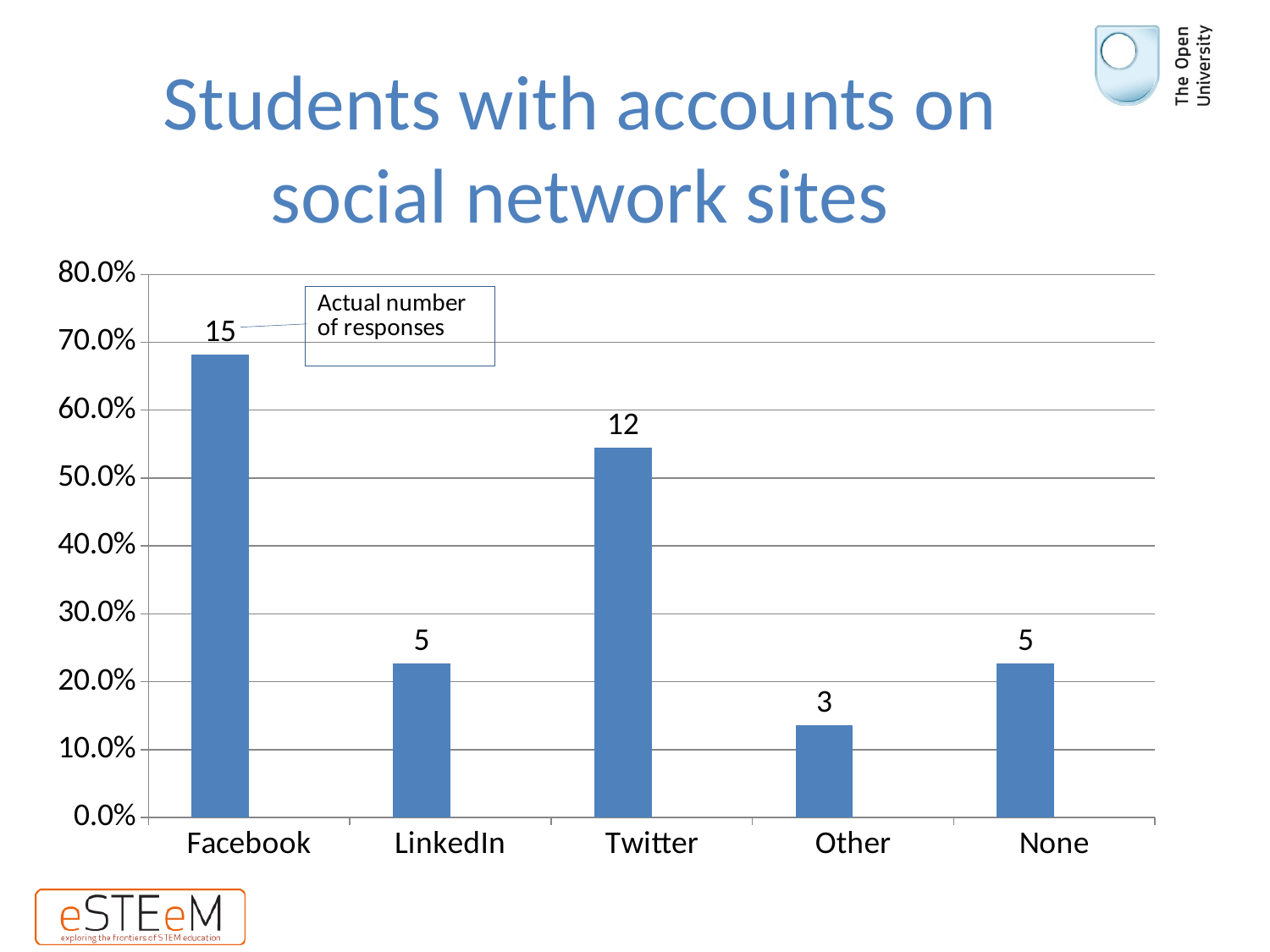
What is the actual number of responses labelled on the Twitter bar? 12 What is the actual number of responses labelled on the LinkedIn bar? 5 Which has the larger value, Twitter or LinkedIn? Twitter What is the difference between the number of responses for Facebook and Twitter? 3 Which category has the highest bar? Facebook Is the percentage value for Facebook greater or less than 60.0%? greater How many categories are shown on the x axis? 5 Is the percentage value for Other greater or less than 20.0%? less What kind of chart is shown on the slide? bar chart What is the actual number of responses labelled on the Facebook bar? 15 Which category has the lowest bar? Other What is the actual number of responses labelled on the Other bar? 3